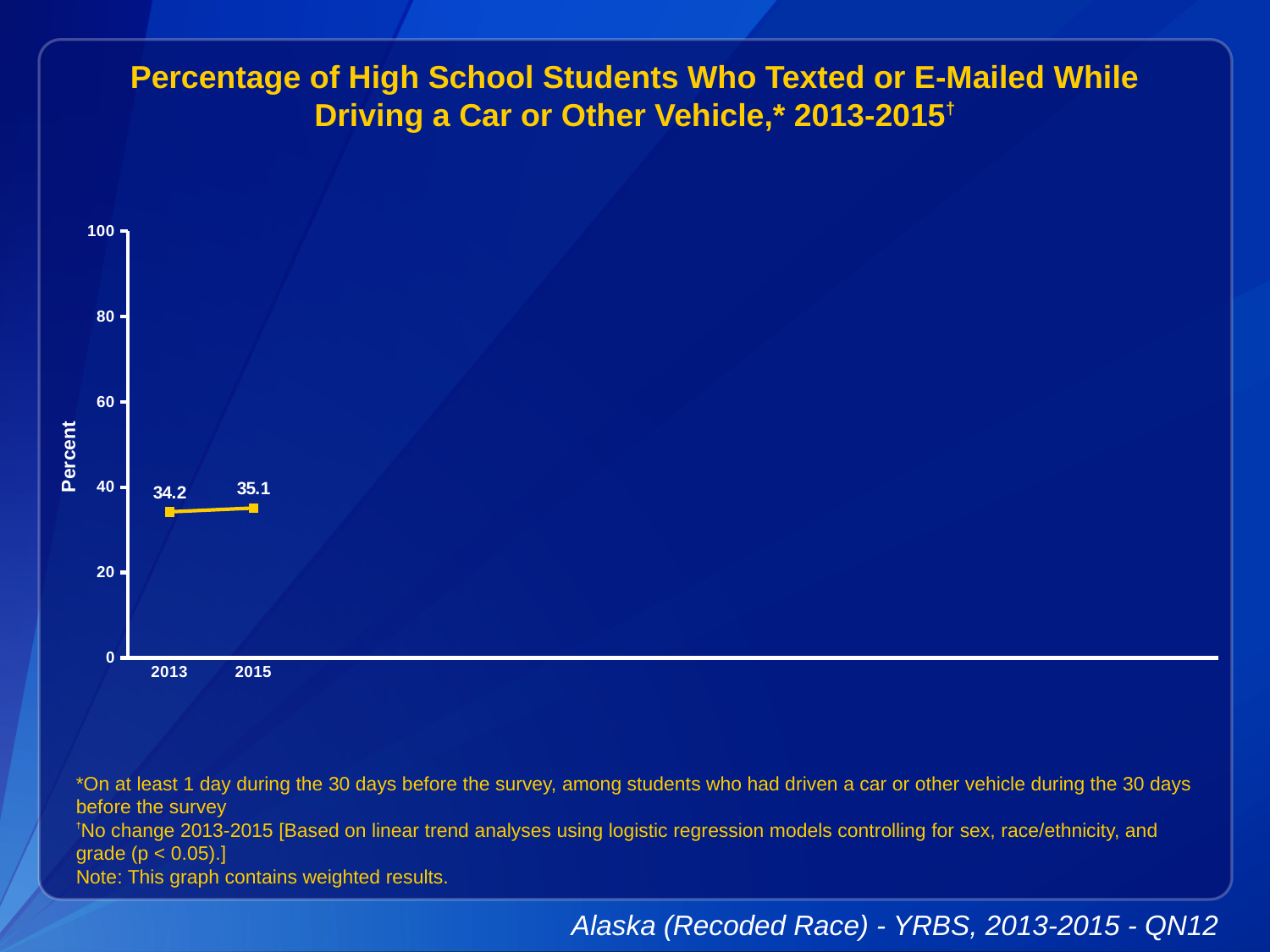
What is the maximum value shown on the y axis? 100 Which year has the lowest value? 2013 Which year has the higher value, 2013 or 2015? 2015 What is the value for 2013? 34.2 How many data points are plotted on the chart? 2 Is the value for 2015 greater or less than 20? greater Is the value for 2013 greater or less than 40? less What is the value for 2015? 35.1 Do the values rise or fall from 2013 to 2015? rise What is the difference between the 2015 and 2013 values? 0.9 What is the label on the y axis? Percent What kind of chart is shown on the slide? line chart